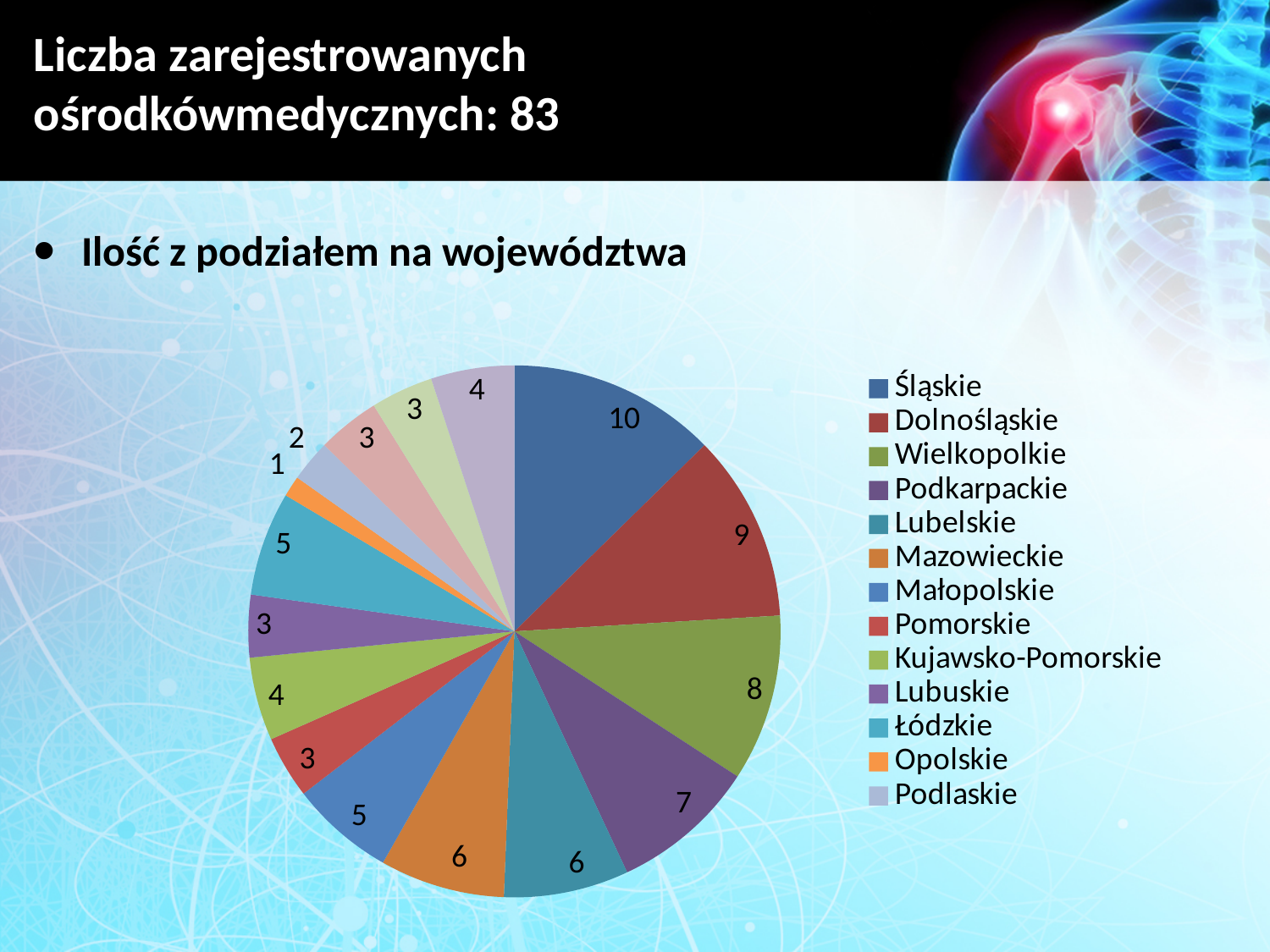
Which voivodeship has the largest slice in the pie chart? Śląskie How many entries does the legend list? 13 What is the value for Opolskie in the pie chart? 1 How many slices does the pie chart have? 16 What is the value for Podlaskie in the pie chart? 2 What is the value for Dolnośląskie in the pie chart? 9 Which voivodeship has the smallest slice in the pie chart? Opolskie What is the value for Śląskie in the pie chart? 10 What is the value for Podkarpackie in the pie chart? 7 What is the difference between the values for Śląskie and Wielkopolkie? 2 What kind of chart is shown on the slide? pie chart Which is larger, the value for Małopolskie or the value for Pomorskie? Małopolskie